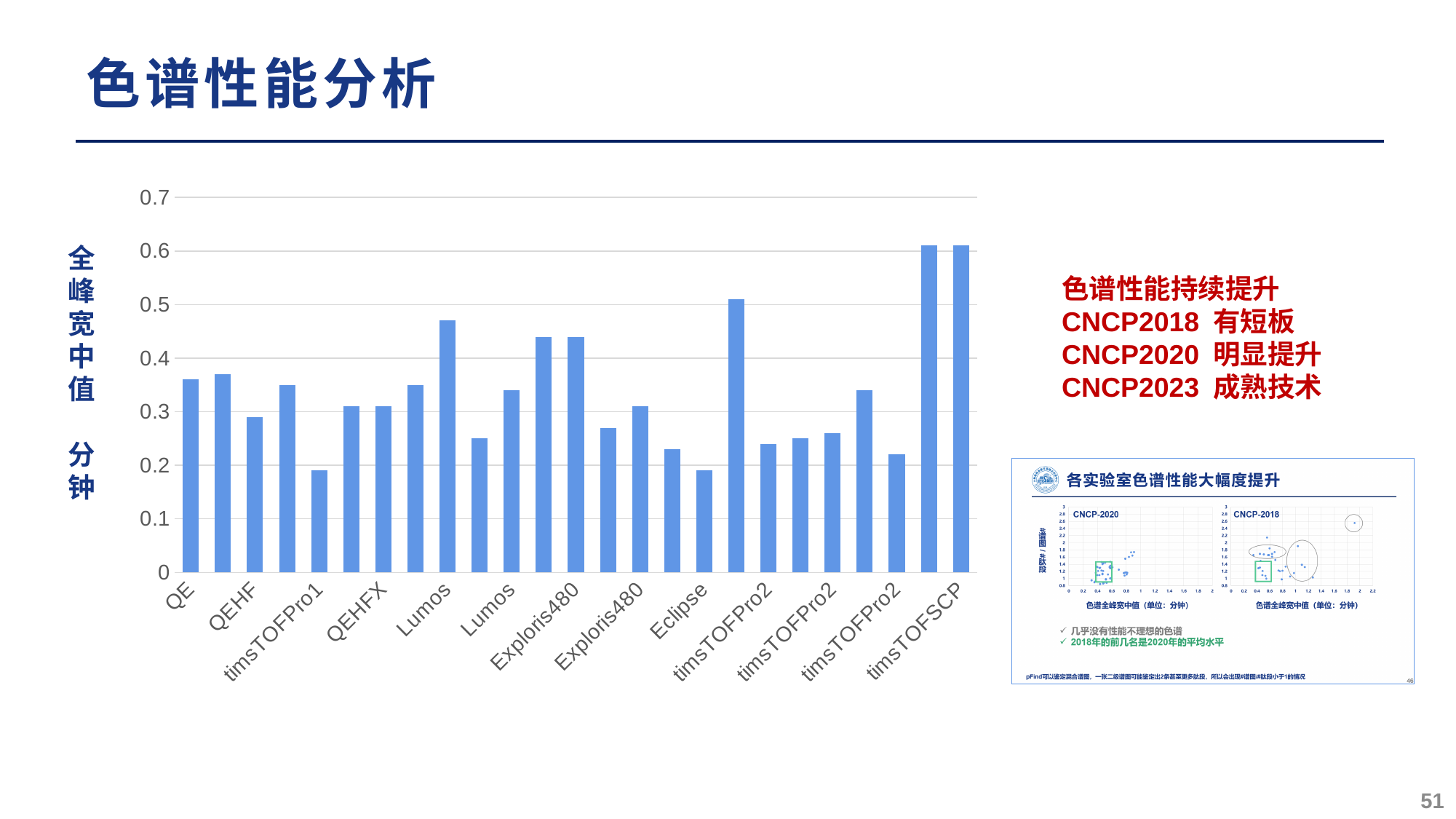
Which has the larger value, QE or QEHF? QE How many bars are plotted in the bar chart? 25 Is the value for timsTOFPro1 greater or less than 0.3? less Is the value for QE greater or less than 0.3? greater What unit is given in the y-axis label of the bar chart? 分钟 Is the value for Eclipse greater or less than 0.3? less Which has the larger value, timsTOFSCP or QE? timsTOFSCP What kind of chart is shown on the slide? bar chart Which has the larger value, Eclipse or QEHFX? QEHFX What is the highest tick value shown on the y axis of the bar chart? 0.7